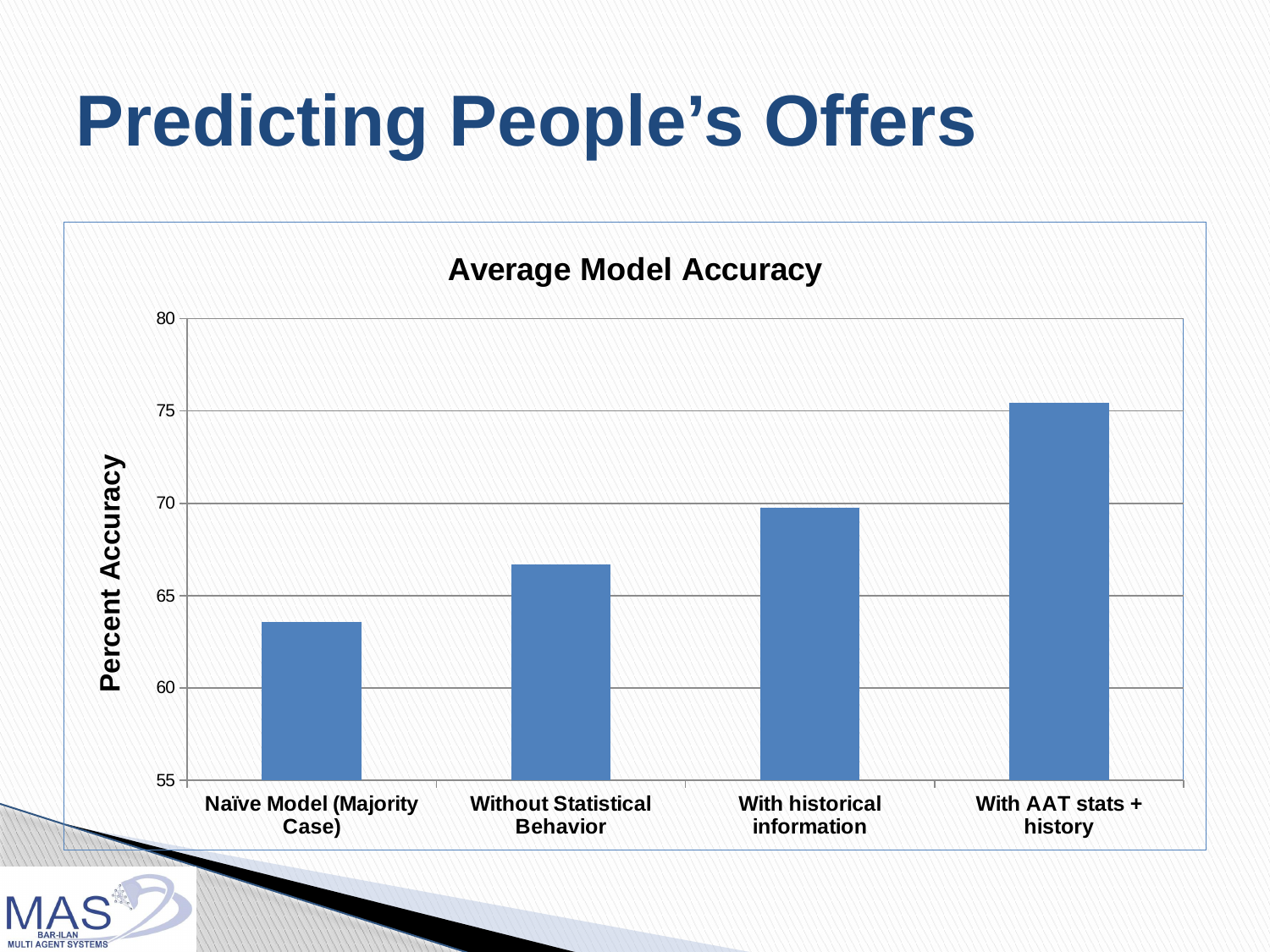
What is the label of the vertical axis? Percent Accuracy Which category has the highest average model accuracy? With AAT stats + history Which category has the lowest average model accuracy? Naïve Model (Majority Case) Is the value for Without Statistical Behavior greater or less than 65? greater Which has a higher accuracy, Without Statistical Behavior or With historical information? With historical information Is the value for Naïve Model (Majority Case) greater or less than 65? less Do the values rise or fall moving from left to right along the x axis? rise How many categories (bars) are shown in the chart? 4 What is the title of the chart? Average Model Accuracy What kind of chart is shown on the slide? bar chart Is the value for With historical information greater or less than 65? greater